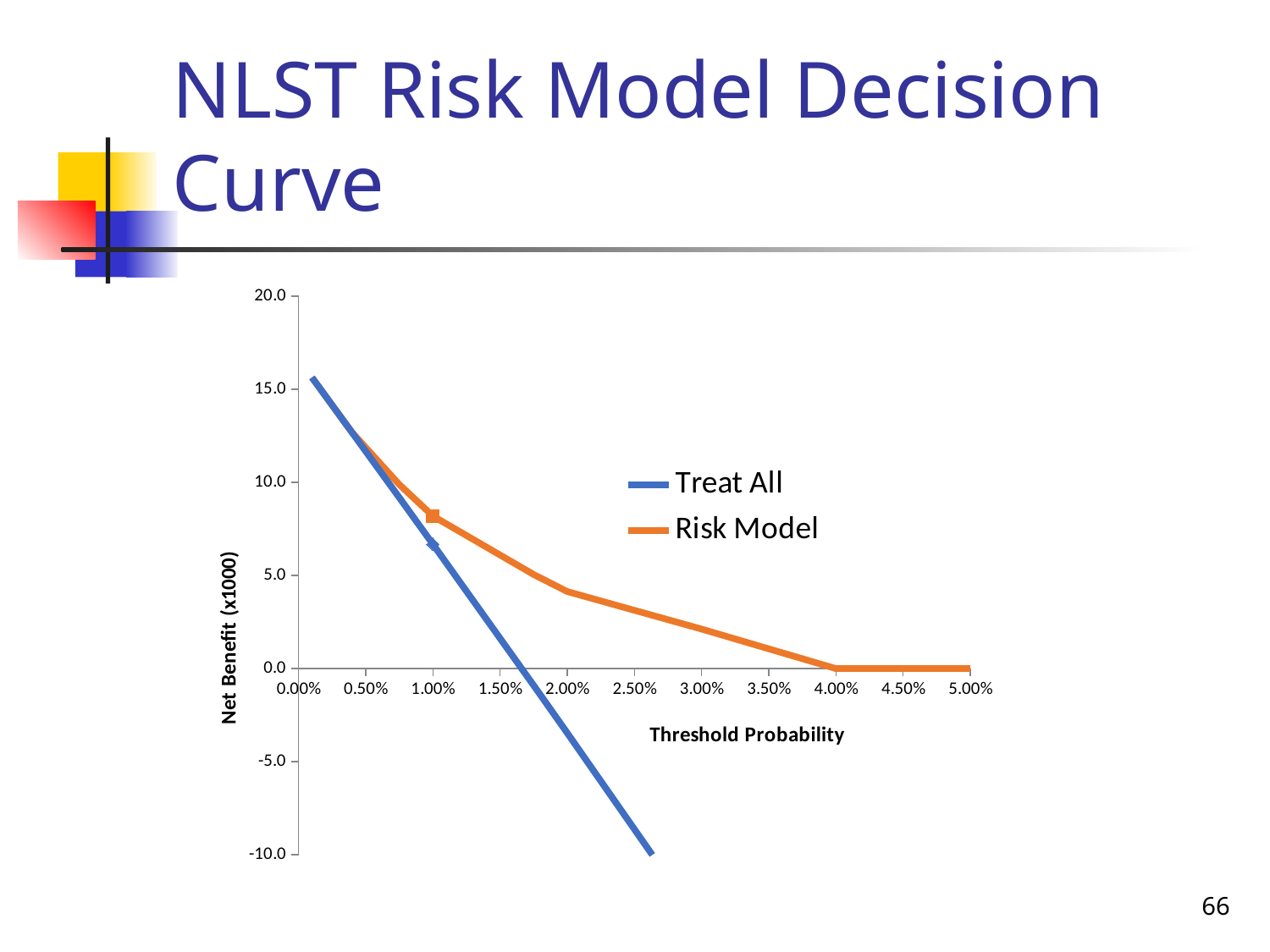
At a Threshold Probability of 2.00%, which series has the higher Net Benefit, Treat All or Risk Model? Risk Model Does the Risk Model line rise or fall as Threshold Probability increases? fall Is the Net Benefit for Risk Model at a Threshold Probability of 1.00% greater or less than 5.0? greater Which series drops to negative Net Benefit values on the chart? Treat All Is the Net Benefit for Treat All at a Threshold Probability of 1.00% greater or less than 10.0? less Is the Net Benefit for Treat All at a Threshold Probability of 2.00% greater or less than 0.0? less How many series does the legend list? 2 What is the title of the vertical axis? Net Benefit (x1000) Does the Treat All line rise or fall as Threshold Probability increases? fall What kind of chart is shown on the slide? line chart What are the two series named in the legend? Treat All and Risk Model